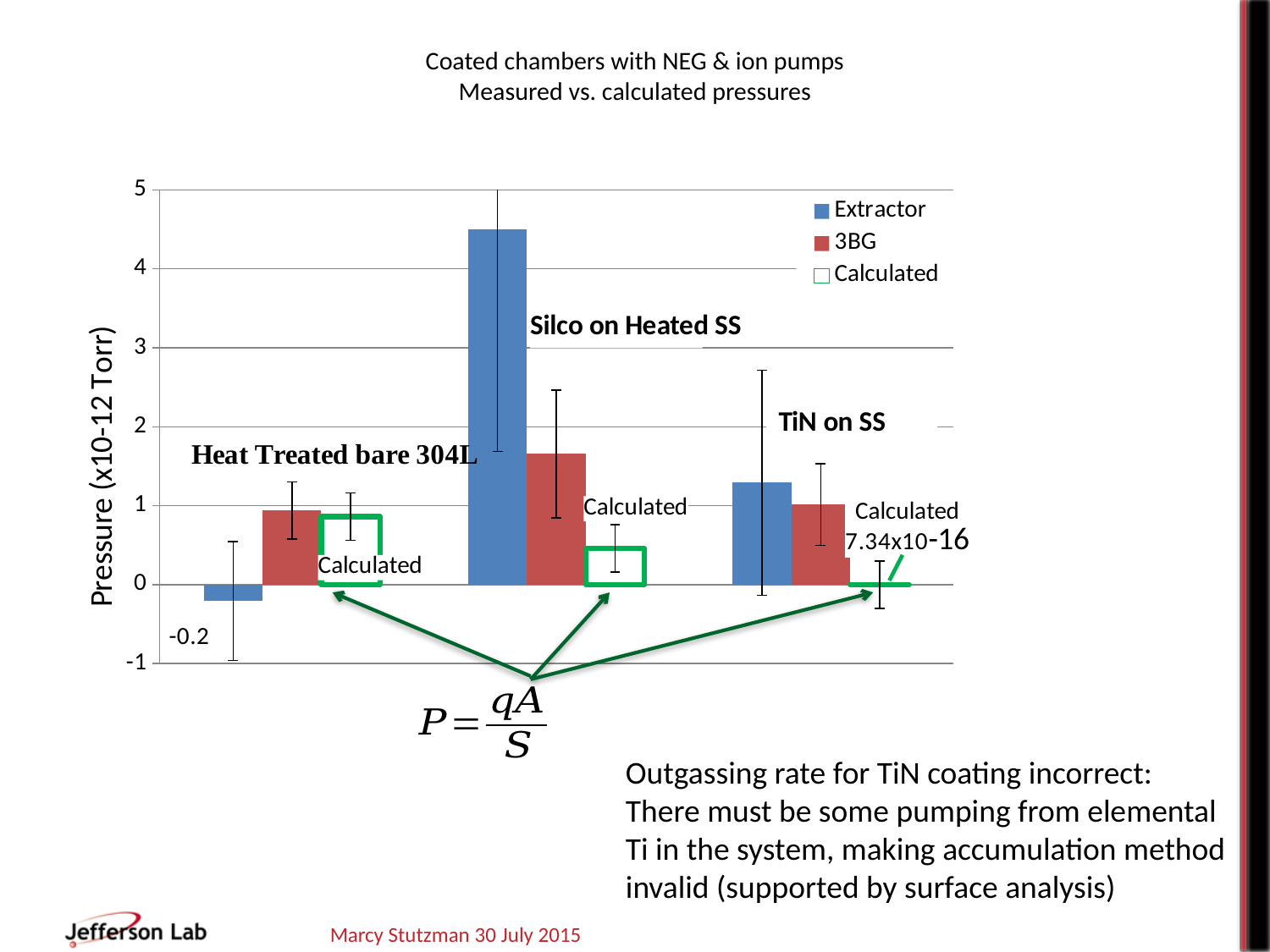
For Heat Treated bare 304L, which is larger, the Extractor value or the 3BG value? 3BG What is the Calculated value for TiN on SS? 7.34x10-16 Is the 3BG value for Silco on Heated SS greater or less than 2? less Is the Extractor value for Silco on Heated SS greater or less than 4? greater What is the label of the vertical axis of the chart? Pressure (x10-12 Torr) How many series does the chart legend list? 3 Which chamber type has the highest Extractor bar? Silco on Heated SS For Silco on Heated SS, which is larger, the Extractor value or the 3BG value? Extractor What is the Extractor value for Heat Treated bare 304L? -0.2 How many chamber types (categories) are plotted in the chart? 3 Which chamber type has the lowest Extractor bar? Heat Treated bare 304L What kind of chart is shown on the slide? bar chart